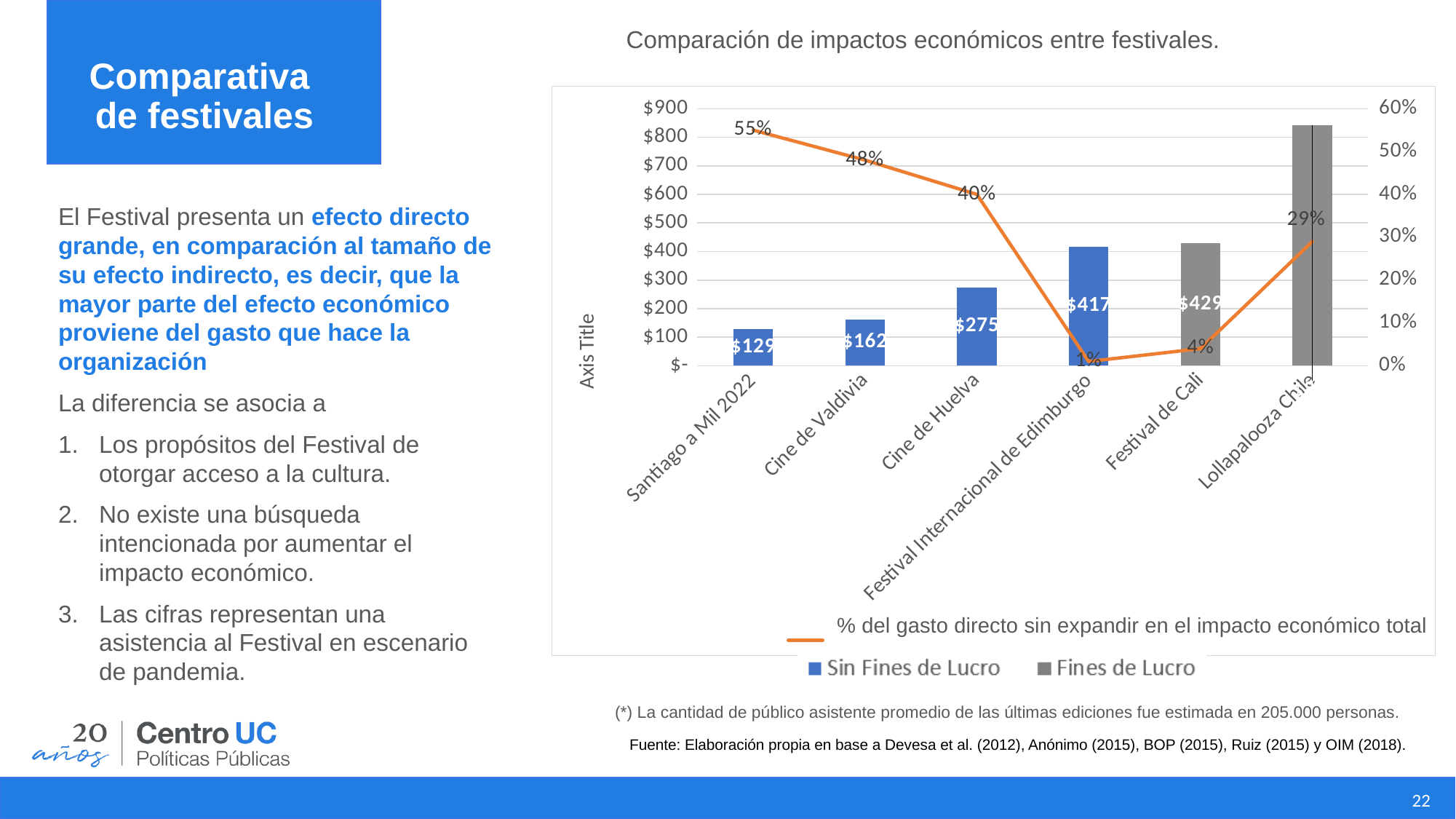
Which has the larger bar value, Cine de Valdivia or Cine de Huelva? Cine de Huelva How many festivals are shown on the x axis? 6 What is the value of the bar for Festival de Cali? $429 Is the bar value for Lollapalooza Chile greater or less than $700? greater What is the value of the bar for Cine de Huelva? $275 What is the difference between the bar values for Festival de Cali and Festival Internacional de Edimburgo? $12 What percentage does the line show for Santiago a Mil 2022? 55% How many series does the legend list? 3 Which festival has the lowest value on the percentage line? Festival Internacional de Edimburgo Which festival has the highest value on the percentage line? Santiago a Mil 2022 Does the percentage line rise or fall from Santiago a Mil 2022 to Festival Internacional de Edimburgo? It falls What kind of chart is shown on the slide? A combination bar and line chart